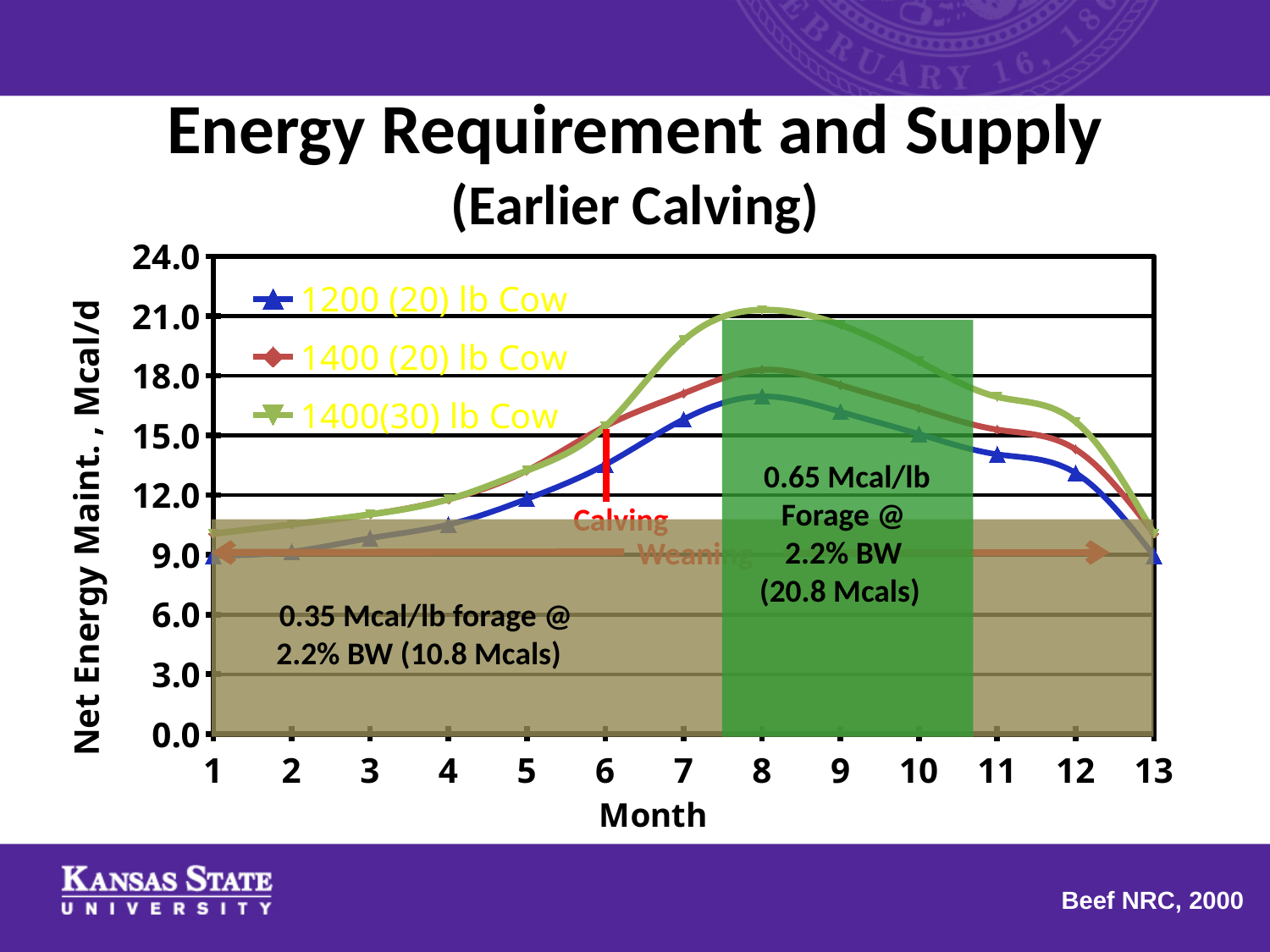
What is the label on the y axis of the chart? Net Energy Maint., Mcal/d Is the value for the 1200 (20) lb Cow series at month 8 greater or less than 15.0? greater How many months are shown along the x axis? 13 Is the value for the 1200 (20) lb Cow series at month 4 greater or less than 12.0? less At which month does the 1400(30) lb Cow series reach its peak? 8 Which series has the lowest value at month 8? 1200 (20) lb Cow At month 11, which is larger: the 1400 (20) lb Cow value or the 1200 (20) lb Cow value? 1400 (20) lb Cow Do the values for the 1200 (20) lb Cow series rise or fall from month 8 to month 13? Fall Which series has the highest value at month 8? 1400(30) lb Cow What kind of chart is shown on the slide? Line chart Is the value for the 1400(30) lb Cow series at month 8 greater or less than 18.0? greater How many series does the legend list? 3